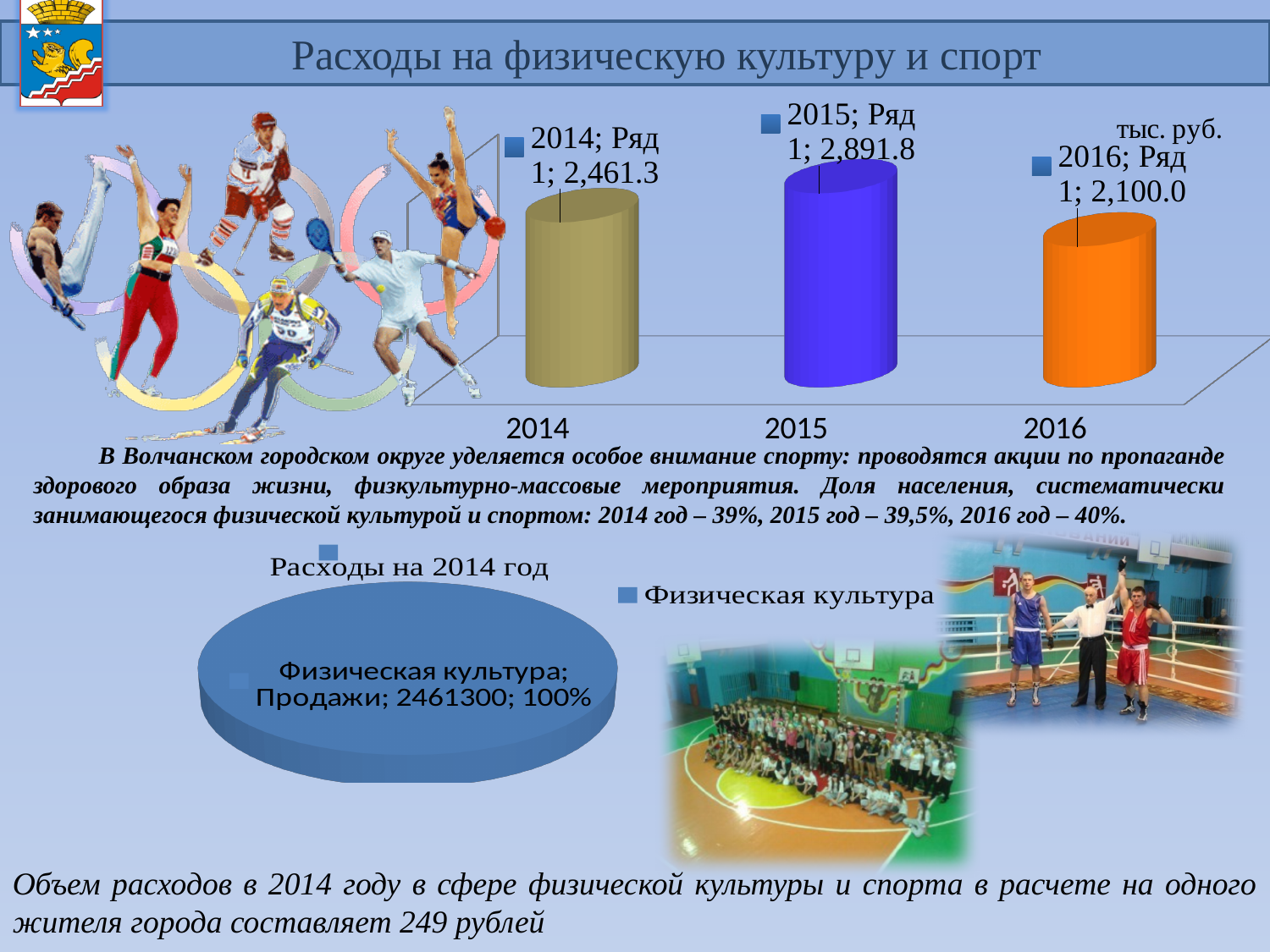
In the bar chart at the top of the slide, what is the difference between the values for 2015 and 2014? 430.5 How many years are shown in the bar chart at the top of the slide? 3 In the bar chart at the top of the slide, what is the difference between the values for 2014 and 2016? 361.3 What kind of chart is shown at the top of the slide? bar chart In the bar chart at the top of the slide, what is the value for 2016? 2,100.0 In the bar chart at the top of the slide, what is the value for 2014? 2,461.3 In the bar chart at the top of the slide, which year has the highest value? 2015 In the bar chart at the top of the slide, what is the value for 2015? 2,891.8 What kind of chart is titled 'Расходы на 2014 год'? pie chart In the bar chart at the top of the slide, which is larger: the value for 2014 or the value for 2016? 2014 In the pie chart titled 'Расходы на 2014 год', what share does 'Физическая культура' have? 100% In the bar chart at the top of the slide, which year has the lowest value? 2016